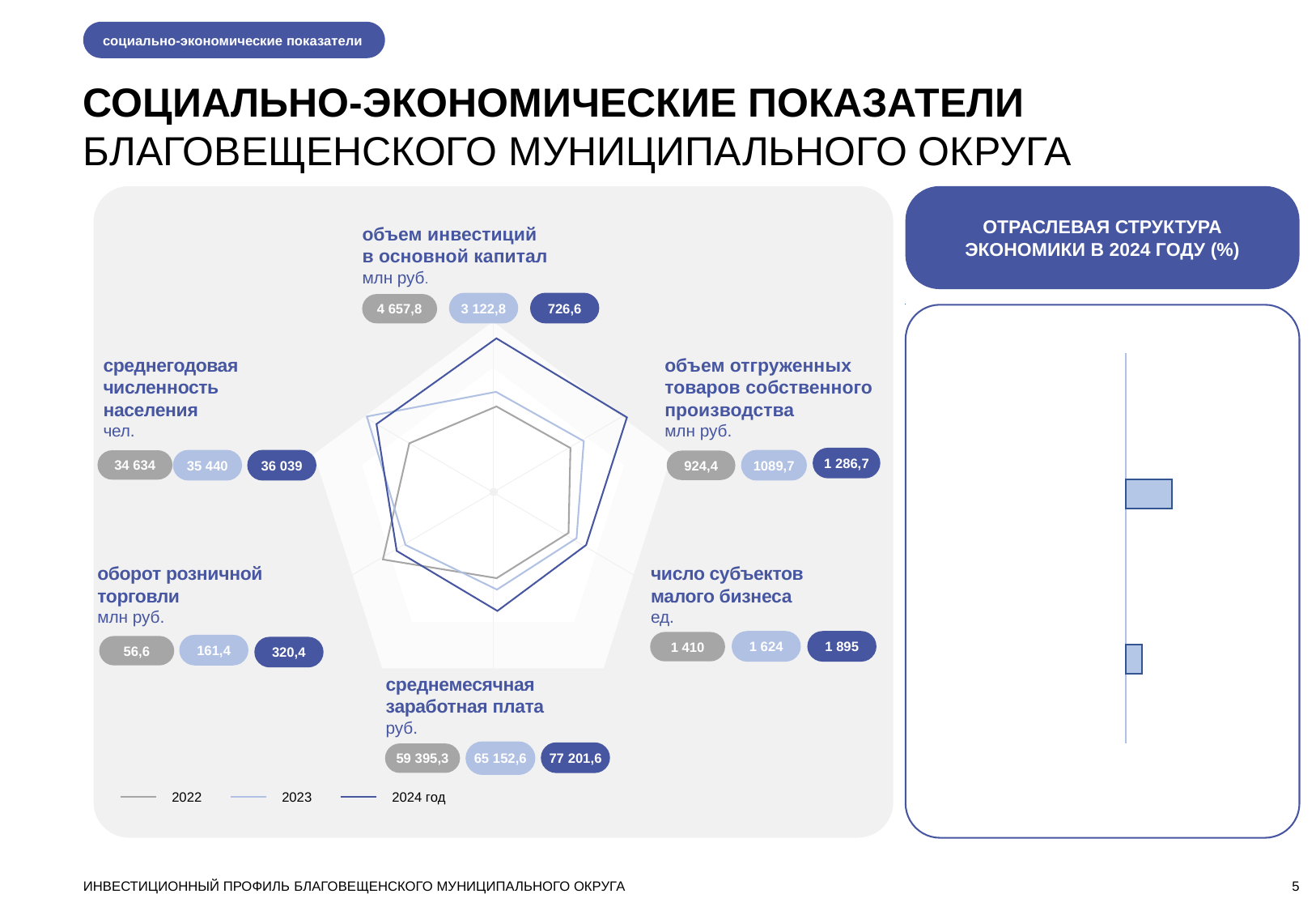
On the left radar chart, by how much did the average annual population grow from 2022 to 2024? 1 405 On the left radar chart, what is the volume of investment in fixed capital (объем инвестиций в основной капитал) for 2024? 726,6 On the left radar chart, which year has the larger volume of shipped goods of own production, 2023 or 2024? 2024 On the left radar chart, what is the average annual population (среднегодовая численность населения) for 2023? 35 440 On the left radar chart, what is the retail trade turnover (оборот розничной торговли) for 2022? 56,6 On the left radar chart, which year has the larger volume of investment in fixed capital, 2022 or 2024? 2022 On the left radar chart, what is the difference between the number of small business entities in 2024 and 2023? 271 On the left radar chart, what is the average monthly salary (среднемесячная заработная плата) for 2024? 77 201,6 How many indicators (axes) does the left radar chart have? 6 On the left radar chart, what is the number of small business entities (число субъектов малого бизнеса) for 2023? 1 624 How many series (years) does the legend of the left radar chart list? 3 What type of chart is the chart on the left of the slide? Radar chart